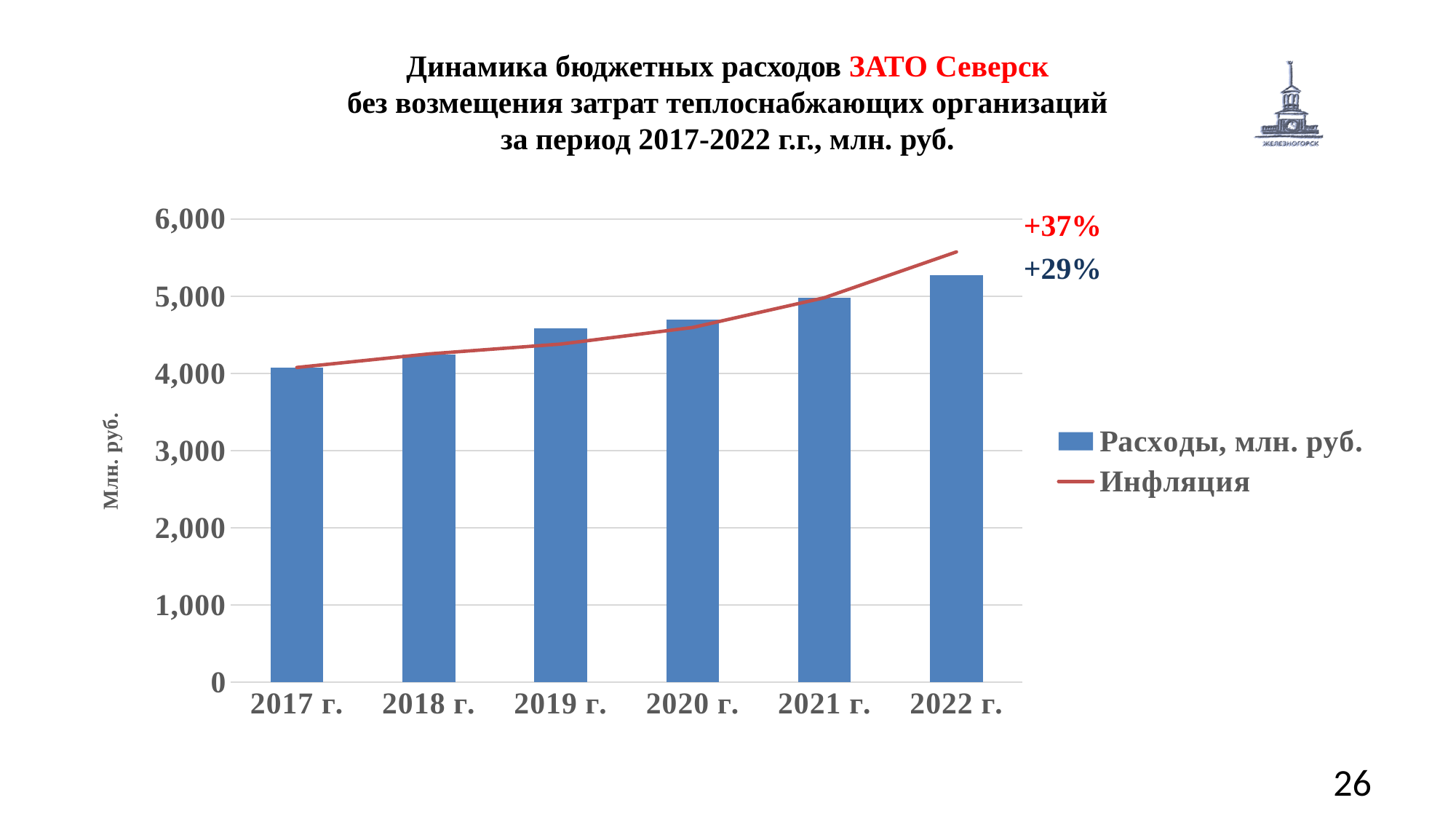
What are the two entries listed in the chart legend? Расходы, млн. руб.; Инфляция Is the Расходы value for 2019 г. greater or less than 5,000? less Do the Расходы bars rise or fall from 2017 г. to 2022 г.? Rise Which year has the lowest bar for Расходы, млн. руб.? 2017 г. How many series does the chart legend list? 2 Is the Расходы value for 2022 г. greater or less than 5,000? greater What percentage growth is shown in red next to the Инфляция line at the right of the chart? +37% How many years are shown on the x axis of the chart? 6 Which year has the larger Расходы bar, 2018 г. or 2019 г.? 2019 г. Is the Расходы value for 2017 г. greater or less than 4,000? greater What kind of chart is shown on the slide? Bar chart with a line overlay Which year has the highest bar for Расходы, млн. руб.? 2022 г.